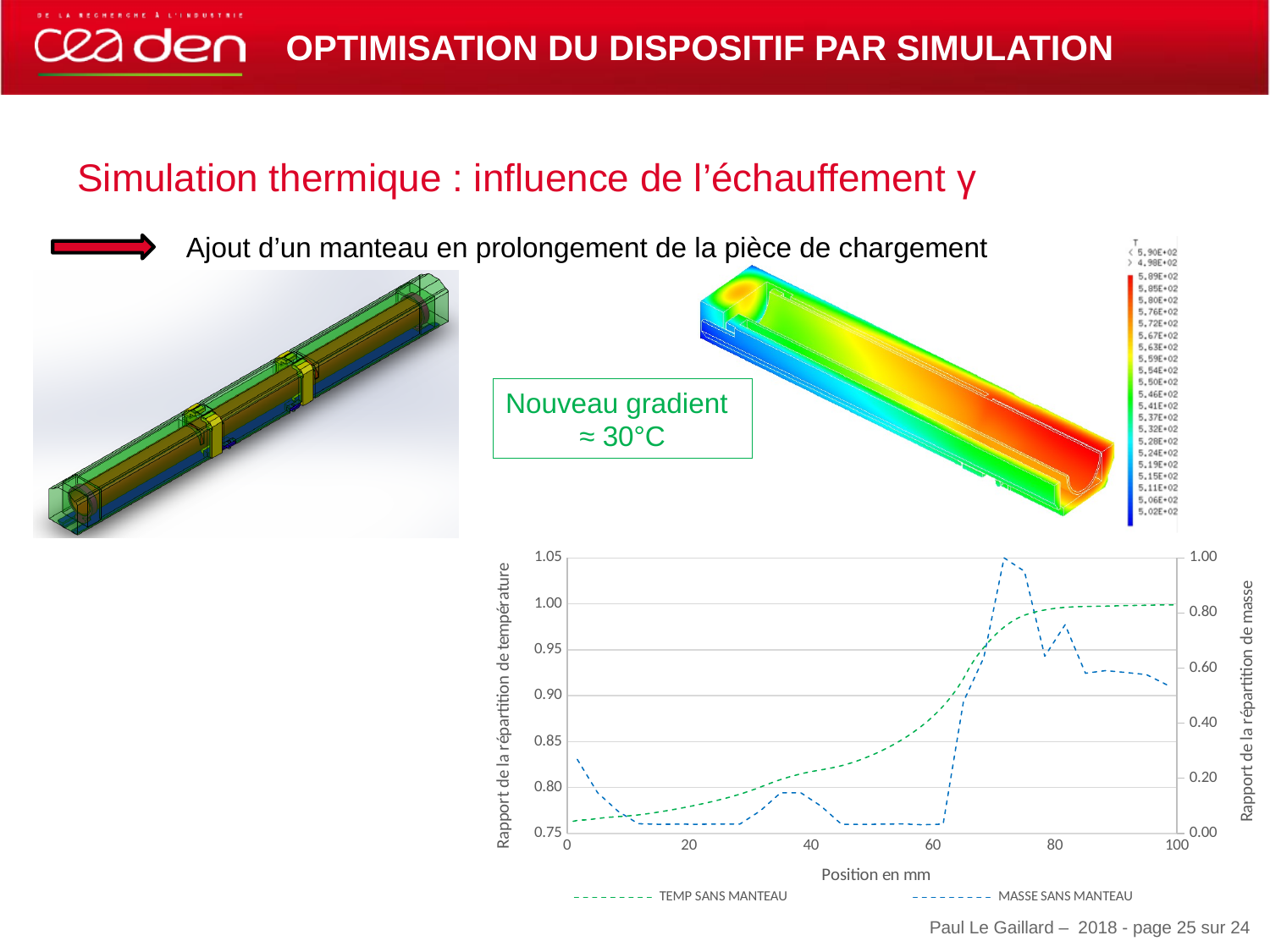
Is the value of MASSE SANS MANTEAU at position 100 mm greater or less than 0.40 on the right axis? greater Does the MASSE SANS MANTEAU series rise or fall between position 60 mm and position 72 mm? rise Is the value of MASSE SANS MANTEAU at position 20 mm greater or less than 0.20 on the right axis? less Does the TEMP SANS MANTEAU series rise or fall overall as position increases from 0 to 100 mm? rise What are the two series named in the legend of the line chart? TEMP SANS MANTEAU and MASSE SANS MANTEAU How many series does the legend of the line chart list? 2 Is the value of TEMP SANS MANTEAU at position 0 mm greater or less than 0.80 on the left axis? less What kind of chart is shown at the bottom of the slide? line chart Does the MASSE SANS MANTEAU series rise or fall between position 0 mm and position 10 mm? fall What is the x-axis title of the line chart? Position en mm